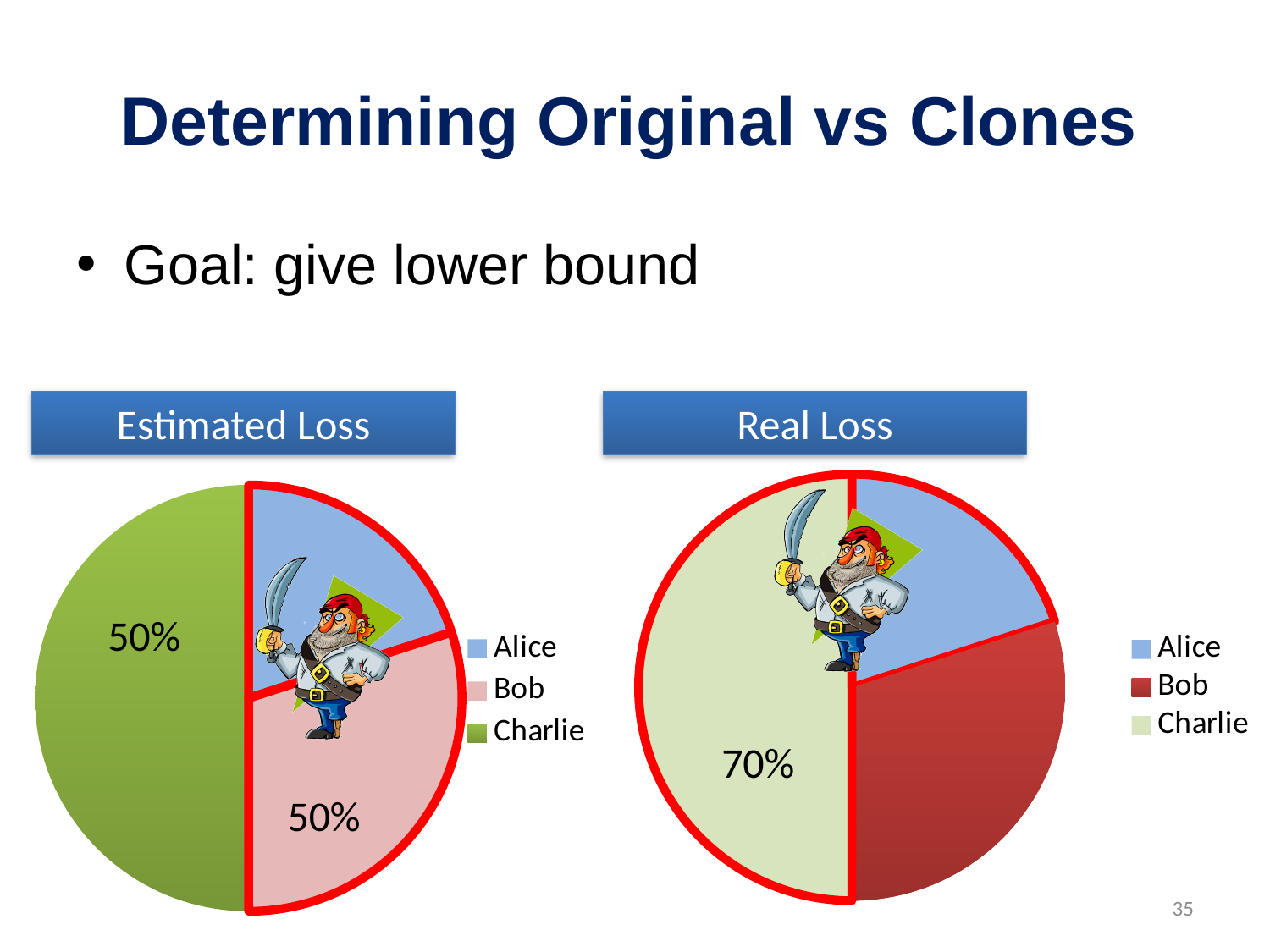
What kind of chart is the Estimated Loss chart? pie chart In the Estimated Loss chart, which category has the smallest slice? Alice In the Estimated Loss chart, which slice is larger, Charlie or Bob? Charlie What are the titles of the two pie charts on the slide? Estimated Loss and Real Loss In the Estimated Loss chart, what share of the pie is Charlie's slice? 50% How many pie charts are shown on the slide? 2 In the Estimated Loss chart, which category has the largest slice? Charlie In the Real Loss chart, which category has the largest slice? Charlie In the Real Loss chart, which slice is larger, Bob or Alice? Bob In the Real Loss chart, which category has the smallest slice? Alice How many entries does the legend of the Real Loss chart list? 3 What percentage label is printed inside the red-outlined region of the Real Loss chart? 70%